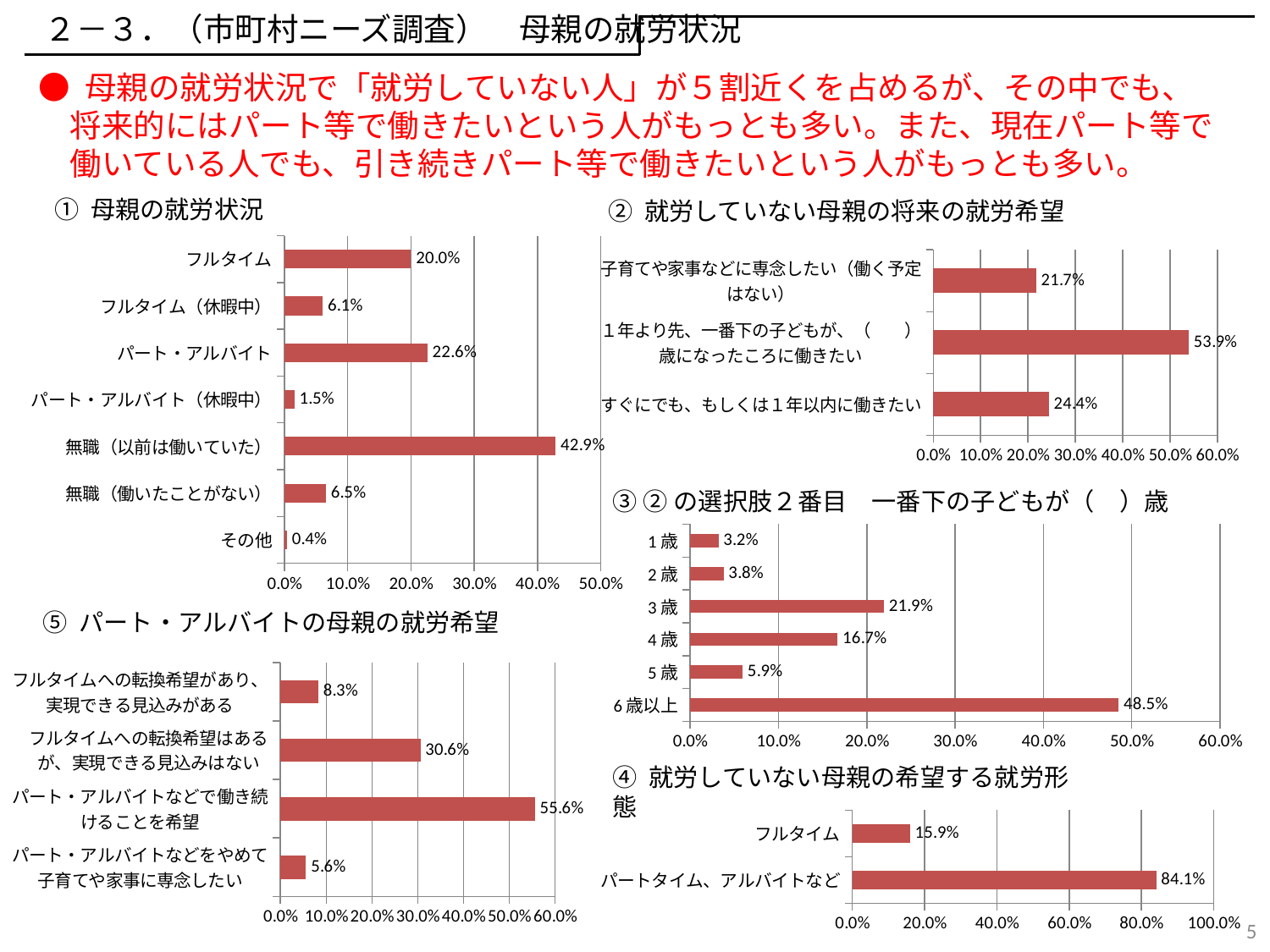
In chart ③ (一番下の子どもが（ ）歳), how many categories are plotted? 6 In chart ⑤ パート・アルバイトの母親の就労希望, what is the value for フルタイムへの転換希望はあるが、実現できる見込みはない? 30.6% What type of chart is chart ⑤ パート・アルバイトの母親の就労希望? bar chart In chart ④ 就労していない母親の希望する就労形態, what is the value for パートタイム、アルバイトなど? 84.1% In chart ① 母親の就労状況, what is the difference between パート・アルバイト and フルタイム? 2.6% In chart ① 母親の就労状況, which category has the lowest value? その他 In chart ② 就労していない母親の将来の就労希望, which category has the highest value? １年より先、一番下の子どもが、（ ）歳になったころに働きたい In chart ① 母親の就労状況, how many categories are plotted? 7 In chart ③ (一番下の子どもが（ ）歳), what is the value for ３歳? 21.9% In chart ② 就労していない母親の将来の就労希望, what is the value for すぐにでも、もしくは１年以内に働きたい? 24.4% In chart ③ (一番下の子どもが（ ）歳), which is larger, ４歳 or ５歳? ４歳 In chart ① 母親の就労状況, what is the value for 無職（以前は働いていた）? 42.9%